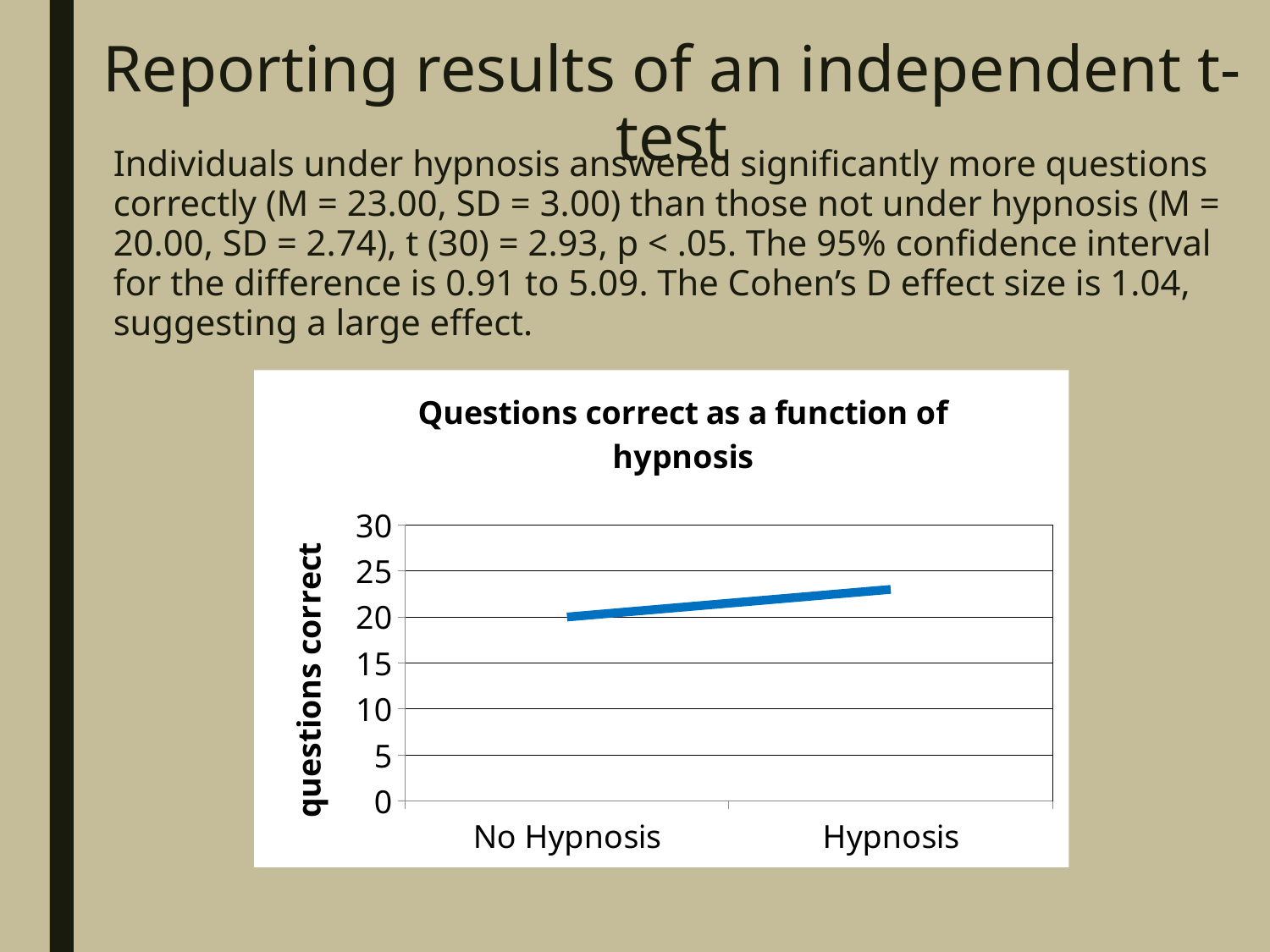
What is the title of the chart? Questions correct as a function of hypnosis Is the value for Hypnosis greater or less than 25? less Is the value for No Hypnosis greater or less than 25? less Which category has the higher number of questions correct? Hypnosis What kind of chart is shown on the slide? line chart Which category has the lower number of questions correct? No Hypnosis Does the line rise or fall from No Hypnosis to Hypnosis? rise How many categories are shown on the x axis of the chart? 2 Is the value for Hypnosis greater or less than 20? greater What is the value for No Hypnosis in the chart? 20 Which is larger, the value for Hypnosis or the value for No Hypnosis? Hypnosis What is the label on the vertical axis of the chart? questions correct